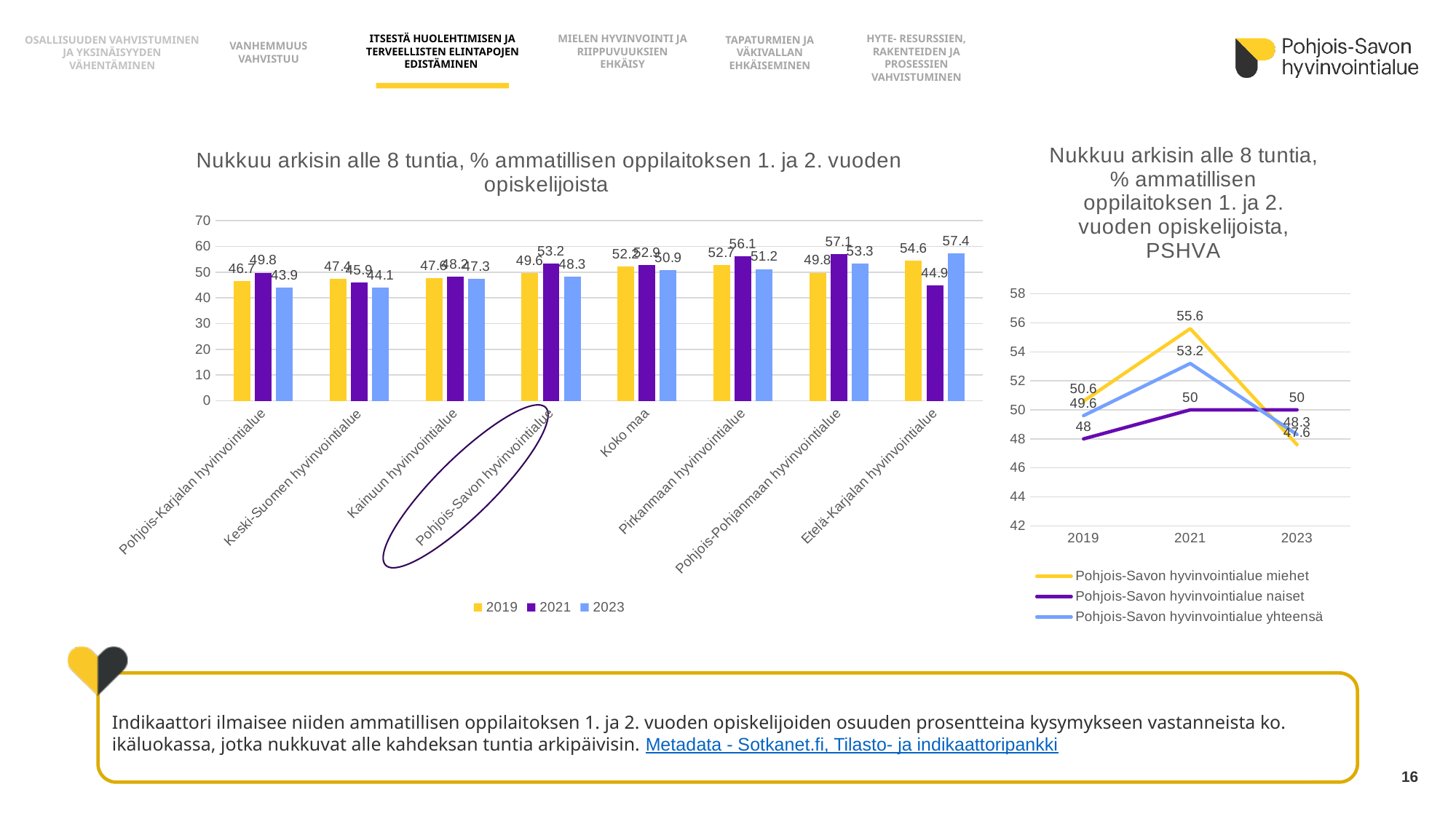
In the bar chart on the left, which category has the lowest 2023 value? Pohjois-Karjalan hyvinvointialue In the bar chart on the left, which is larger for Etelä-Karjalan hyvinvointialue: the 2019 value or the 2021 value? 2019 In the line chart on the right, what is the difference between the 2019 and 2021 values for Pohjois-Savon hyvinvointialue naiset? 2 In the bar chart on the left, what is the difference between the 2021 and 2023 values for Pohjois-Savon hyvinvointialue? 4.9 In the line chart on the right, does the value for Pohjois-Savon hyvinvointialue miehet rise or fall from 2021 to 2023? Fall In the line chart on the right, what is the 2021 value for Pohjois-Savon hyvinvointialue miehet? 55.6 In the bar chart on the left, what is the 2021 value for Pohjois-Savon hyvinvointialue? 53.2 How many categories are shown on the x axis of the bar chart on the left? 8 What kind of chart is the chart on the right of the slide? Line chart How many series does the legend of the bar chart on the left list? 3 In the bar chart on the left, which category has the highest 2021 value? Pohjois-Pohjanmaan hyvinvointialue In the bar chart on the left, what is the 2023 value for Etelä-Karjalan hyvinvointialue? 57.4